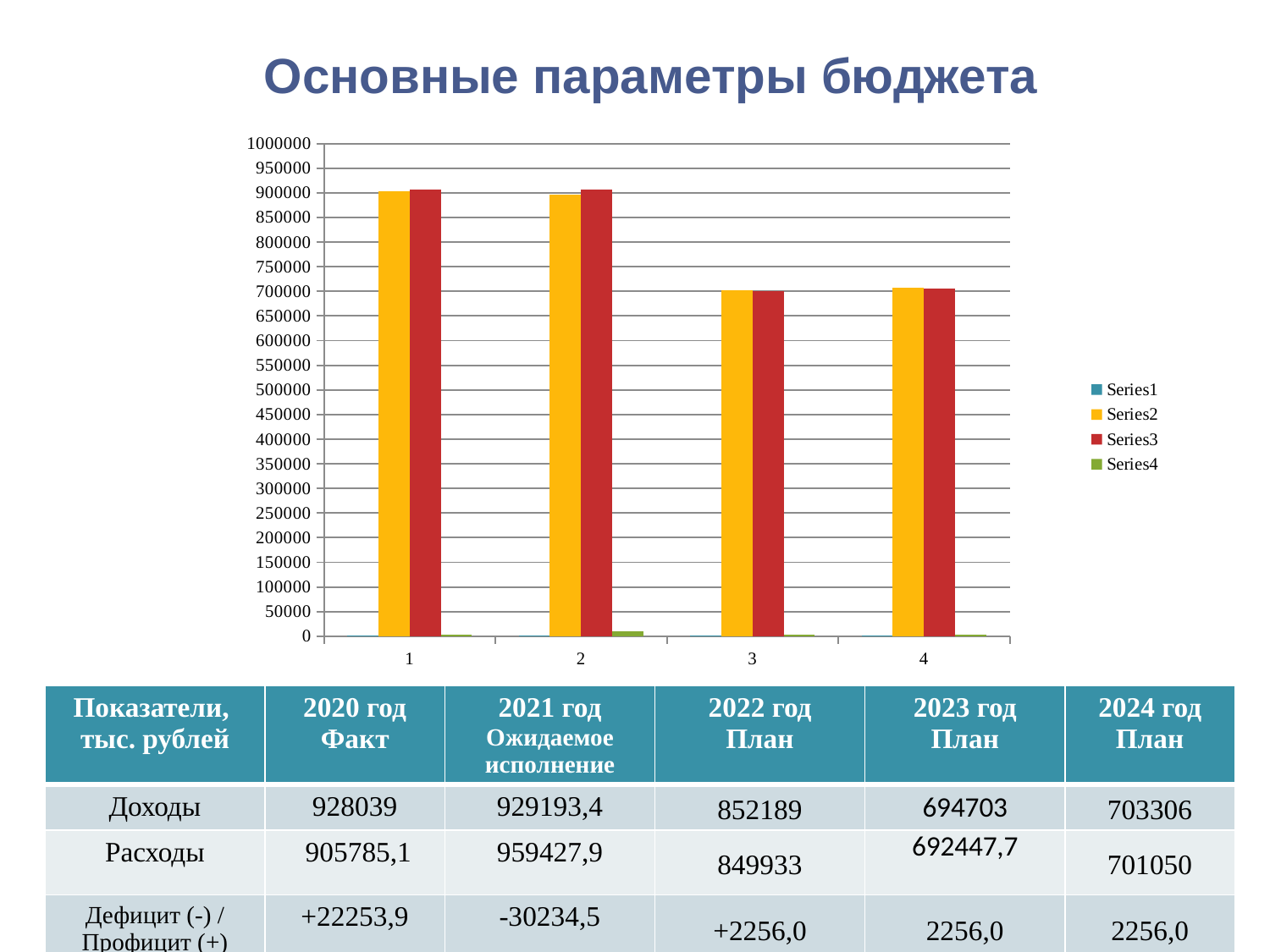
Is the Series3 value for category 1 greater or less than 800000? greater Overall, do the Series2 bars rise or fall from category 1 to category 4? fall What kind of chart is shown on the slide? bar chart Which is larger: the Series3 value for category 2 or the Series3 value for category 4? category 2 How many series does the chart legend list? 4 Is the Series2 value for category 4 greater or less than 650000? greater What is the title of the slide containing the chart? Основные параметры бюджета How many categories are shown on the x axis of the chart? 4 Is the Series3 value for category 3 greater or less than 750000? less Which is larger: the Series2 value for category 1 or the Series2 value for category 3? category 1